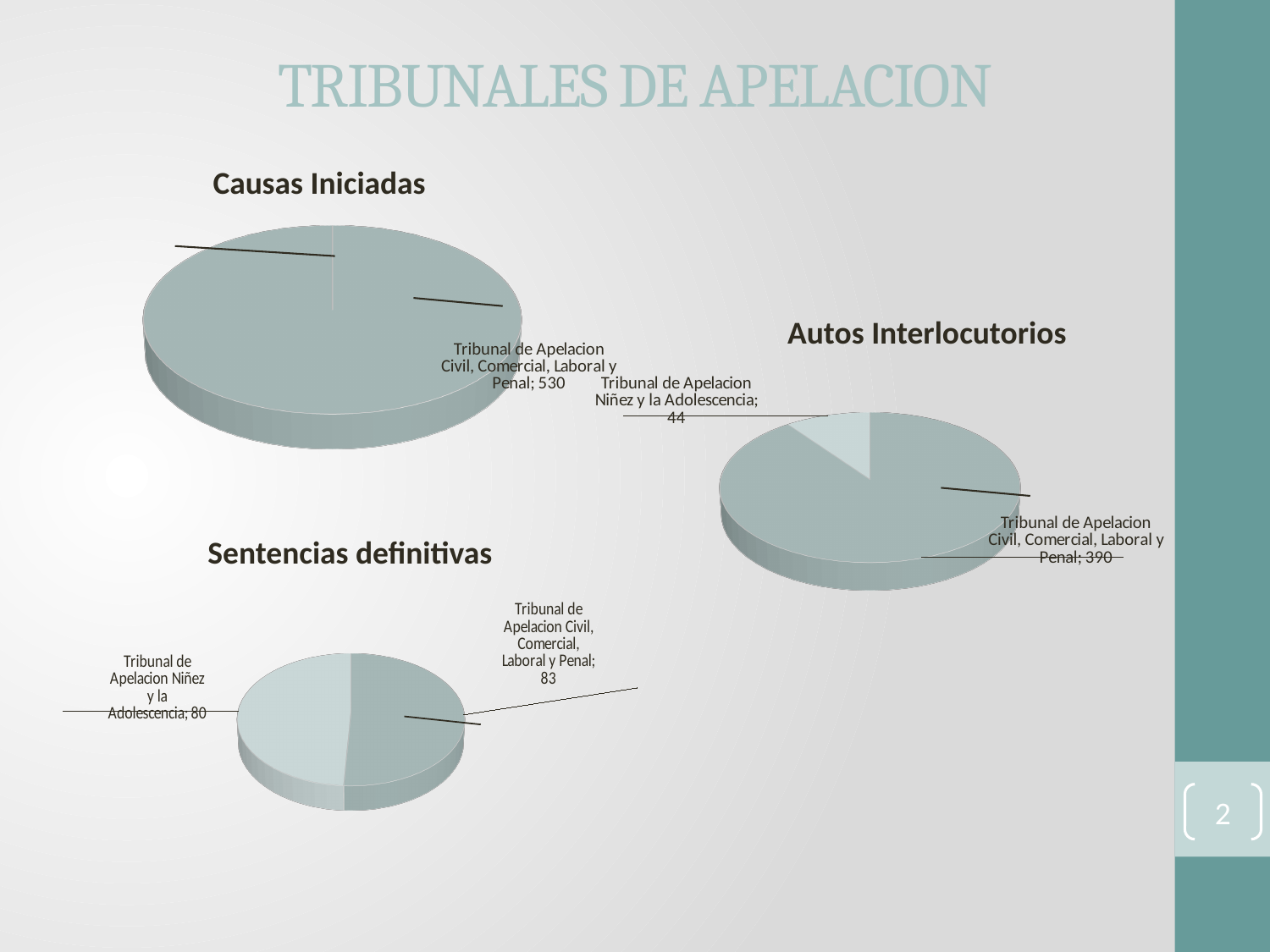
In the Sentencias definitivas chart, what is the difference between the values for Tribunal de Apelacion Civil, Comercial, Laboral y Penal and Tribunal de Apelacion Niñez y la Adolescencia? 3 In the Autos Interlocutorios chart, what is the value for Tribunal de Apelacion Niñez y la Adolescencia? 44 In the Sentencias definitivas chart, what is the value for Tribunal de Apelacion Civil, Comercial, Laboral y Penal? 83 In the Autos Interlocutorios chart, what is the total of the two labelled slices? 434 In the Autos Interlocutorios chart, what is the value for Tribunal de Apelacion Civil, Comercial, Laboral y Penal? 390 In the Sentencias definitivas chart, what is the value for Tribunal de Apelacion Niñez y la Adolescencia? 80 In the Autos Interlocutorios chart, which tribunal has the largest slice? Tribunal de Apelacion Civil, Comercial, Laboral y Penal In the Causas Iniciadas chart, what is the value for Tribunal de Apelacion Civil, Comercial, Laboral y Penal? 530 In the Autos Interlocutorios chart, what is the difference between the values for Tribunal de Apelacion Civil, Comercial, Laboral y Penal and Tribunal de Apelacion Niñez y la Adolescencia? 346 In the Sentencias definitivas chart, what is the total of the two slices? 163 What kind of chart is the Sentencias definitivas chart? Pie chart In the Sentencias definitivas chart, which has the larger value: Tribunal de Apelacion Civil, Comercial, Laboral y Penal or Tribunal de Apelacion Niñez y la Adolescencia? Tribunal de Apelacion Civil, Comercial, Laboral y Penal